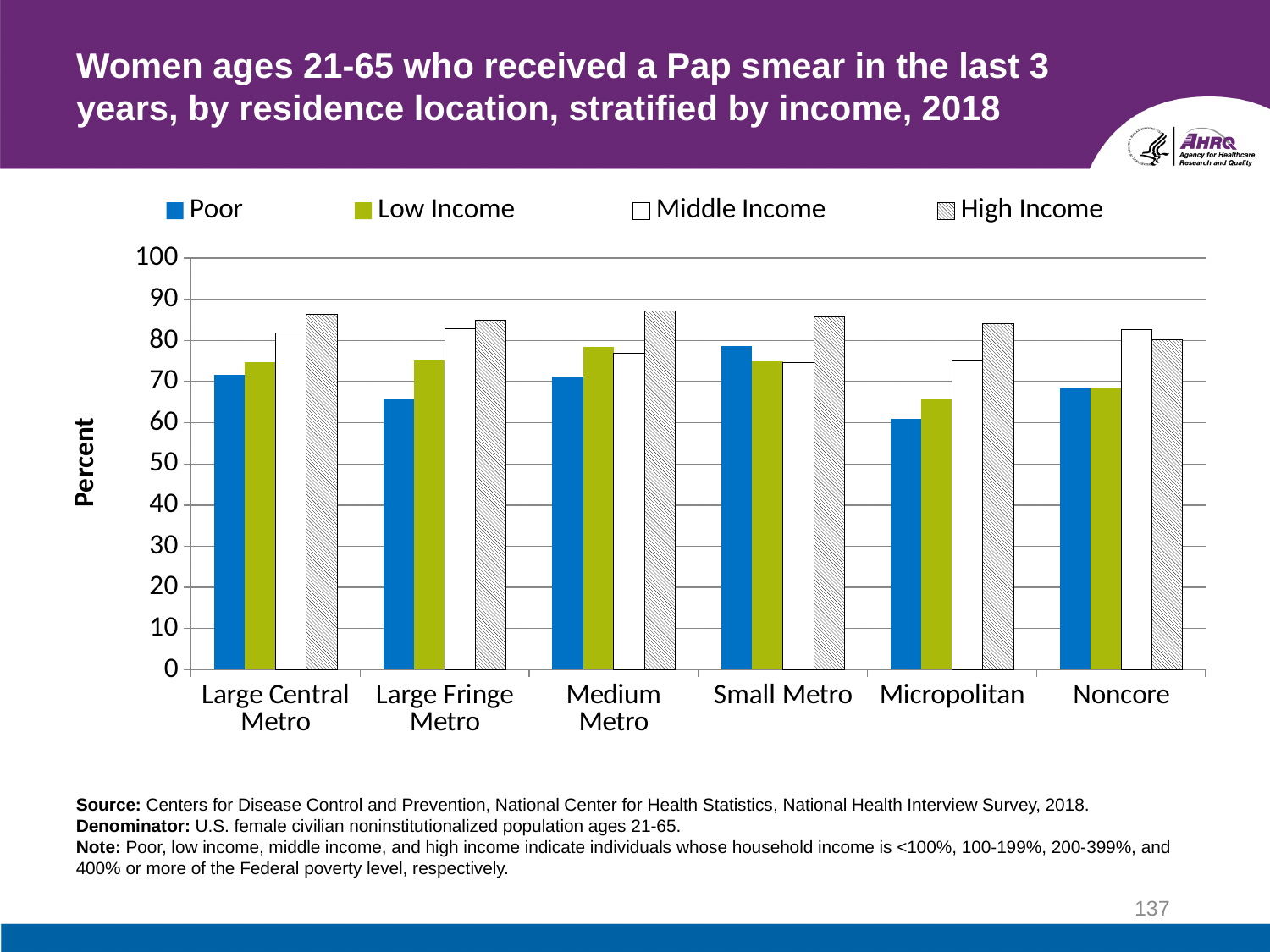
What is the label on the y axis? Percent How many series does the legend list? 4 Is the value for Poor in Large Fringe Metro greater or less than 70? less How many residence location categories are shown on the x axis? 6 Is the value for Poor in Micropolitan greater or less than 70? less Which income group has the highest value in Micropolitan? High Income What kind of chart is shown on the slide? Bar chart In Large Fringe Metro, which is larger: the Poor value or the Middle Income value? Middle Income Is the value for High Income in Medium Metro greater or less than 80? greater Which residence location has the lowest value for the Poor series? Micropolitan In Small Metro, which is larger: the Poor value or the Low Income value? Poor